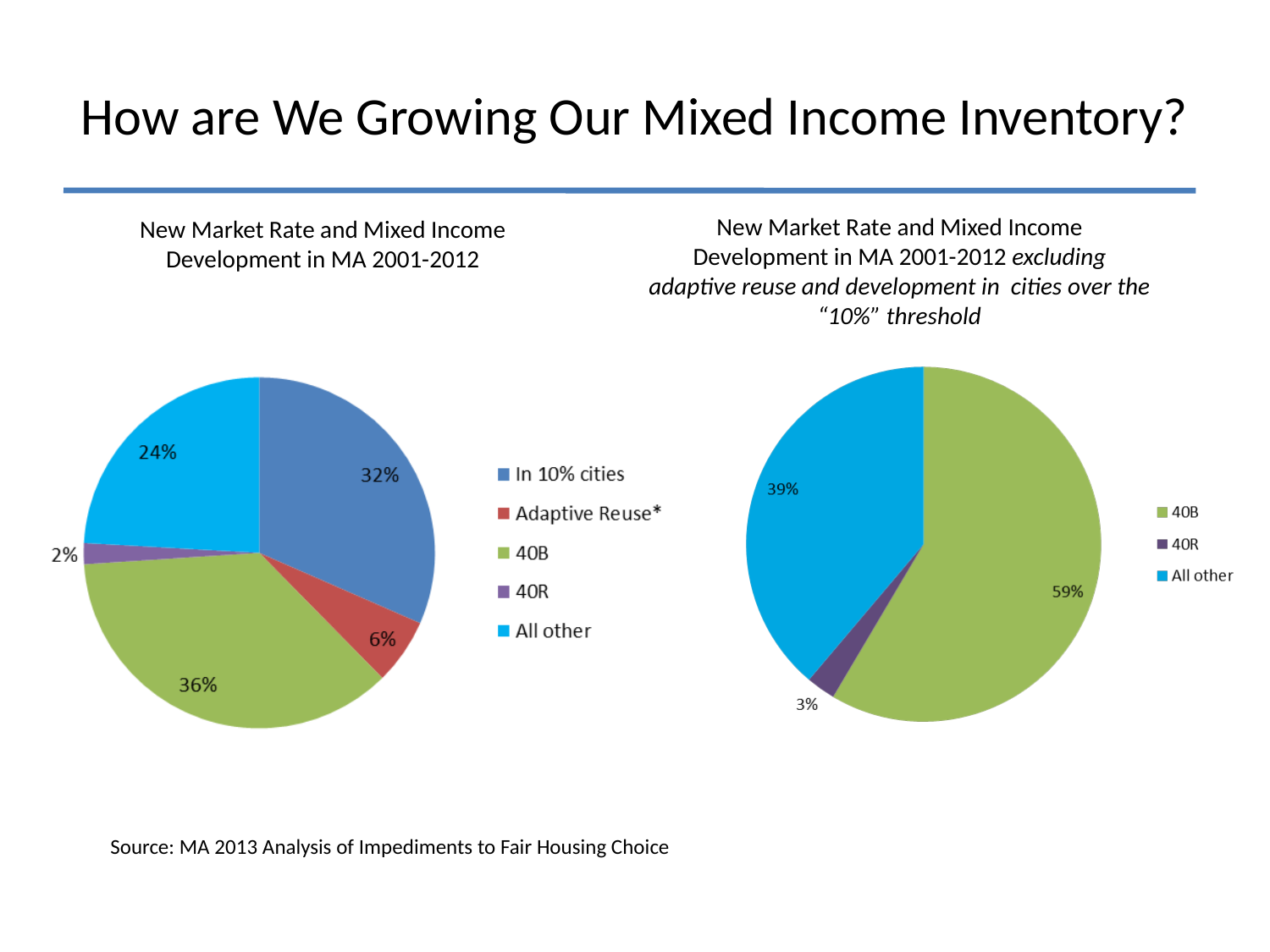
In the right pie chart, what share of development is All other? 39% In the left pie chart, what share of development is in 10% cities? 32% In the left pie chart, which category has the smallest share? 40R In the right pie chart, which category has the smallest share? 40R In the left pie chart, which category has the largest share? 40B In the left pie chart, how many categories does the legend list? 5 In the left pie chart, what share of development is Adaptive Reuse? 6% In the right pie chart, what share of development is 40B? 59% In the left pie chart, what share of development is 40B? 36% What type of chart is used on the right side of the slide? Pie chart In the right pie chart, how many categories does the legend list? 3 In the left pie chart, what is the difference between the 40B share and the All other share? 12%